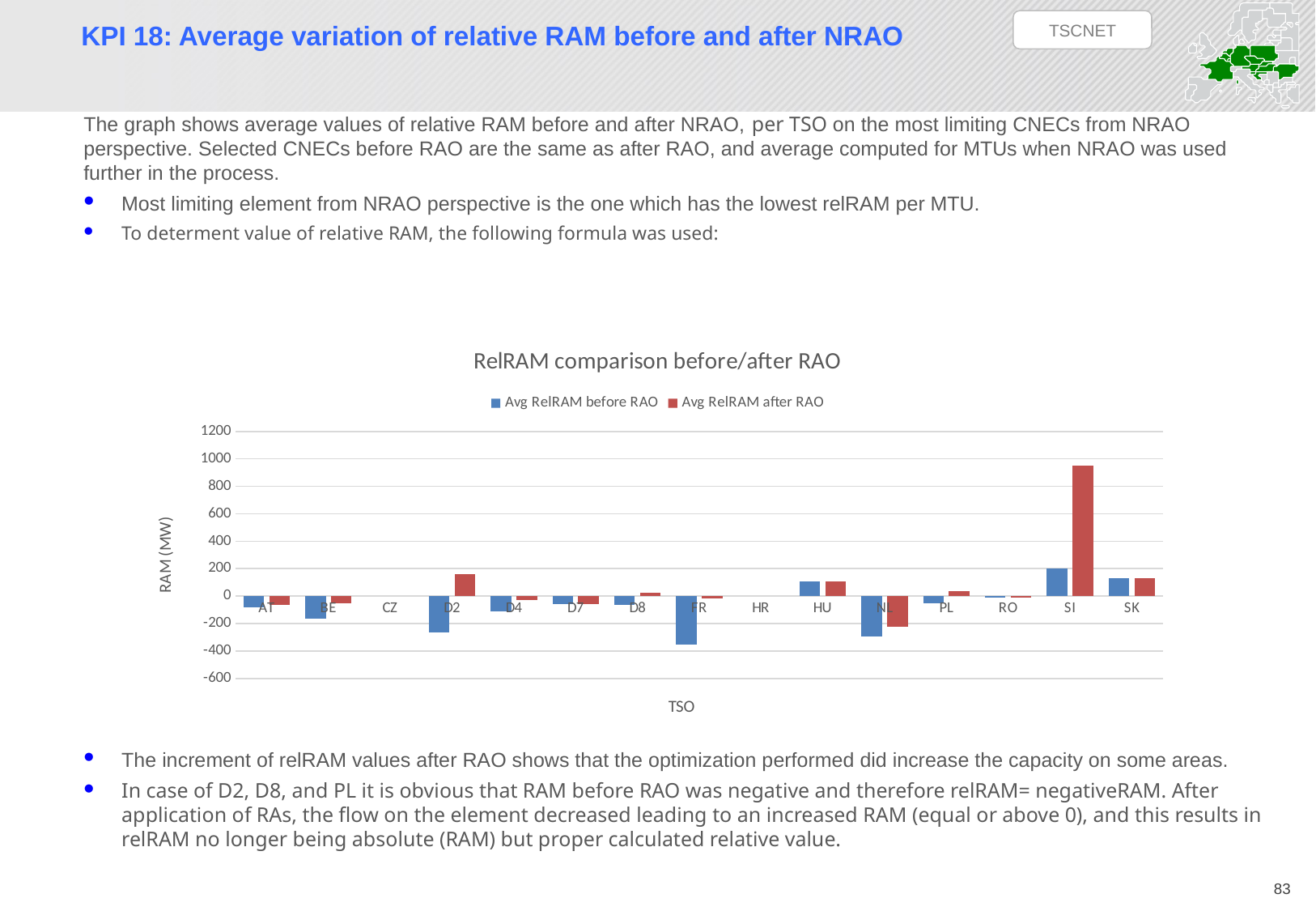
Is the Avg RelRAM after RAO value for SI greater or less than 800? greater What type of chart is shown on the slide? bar chart For D2, which is larger: Avg RelRAM before RAO or Avg RelRAM after RAO? Avg RelRAM after RAO How many series does the legend of the RelRAM comparison chart list? 2 Which TSO has the highest Avg RelRAM after RAO value? SI Is the Avg RelRAM before RAO value for NL greater or less than -200? less Is the Avg RelRAM before RAO value for FR greater or less than -200? less For SI, which is larger: Avg RelRAM before RAO or Avg RelRAM after RAO? Avg RelRAM after RAO How many TSO categories are shown on the x axis of the chart? 15 What is the title of the chart? RelRAM comparison before/after RAO What is the label of the vertical axis of the chart? RAM (MW) Which TSO has the lowest Avg RelRAM before RAO value? FR